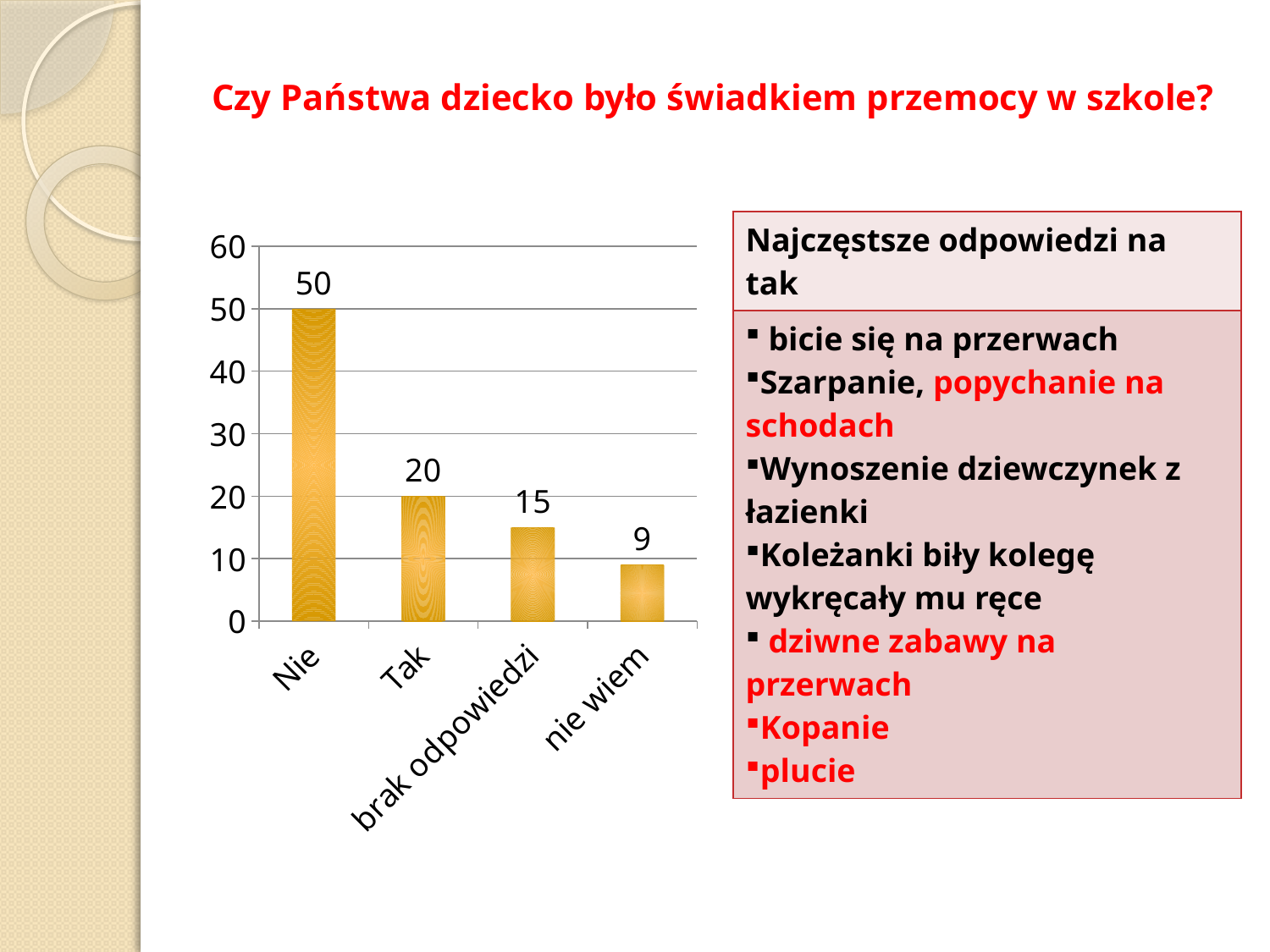
What is the difference between the values for "brak odpowiedzi" and "nie wiem"? 6 What is the value for "nie wiem"? 9 What is the value for "brak odpowiedzi"? 15 Which category has the highest value? Nie Which category has the lowest value? nie wiem Which is larger, the value for "Tak" or the value for "brak odpowiedzi"? Tak How many categories are shown on the x axis? 4 What is the difference between the values for "Nie" and "Tak"? 30 What is the value for "Tak"? 20 Do the values rise or fall from left to right along the x axis? fall What kind of chart is shown on the slide? bar chart What is the value for "Nie"? 50